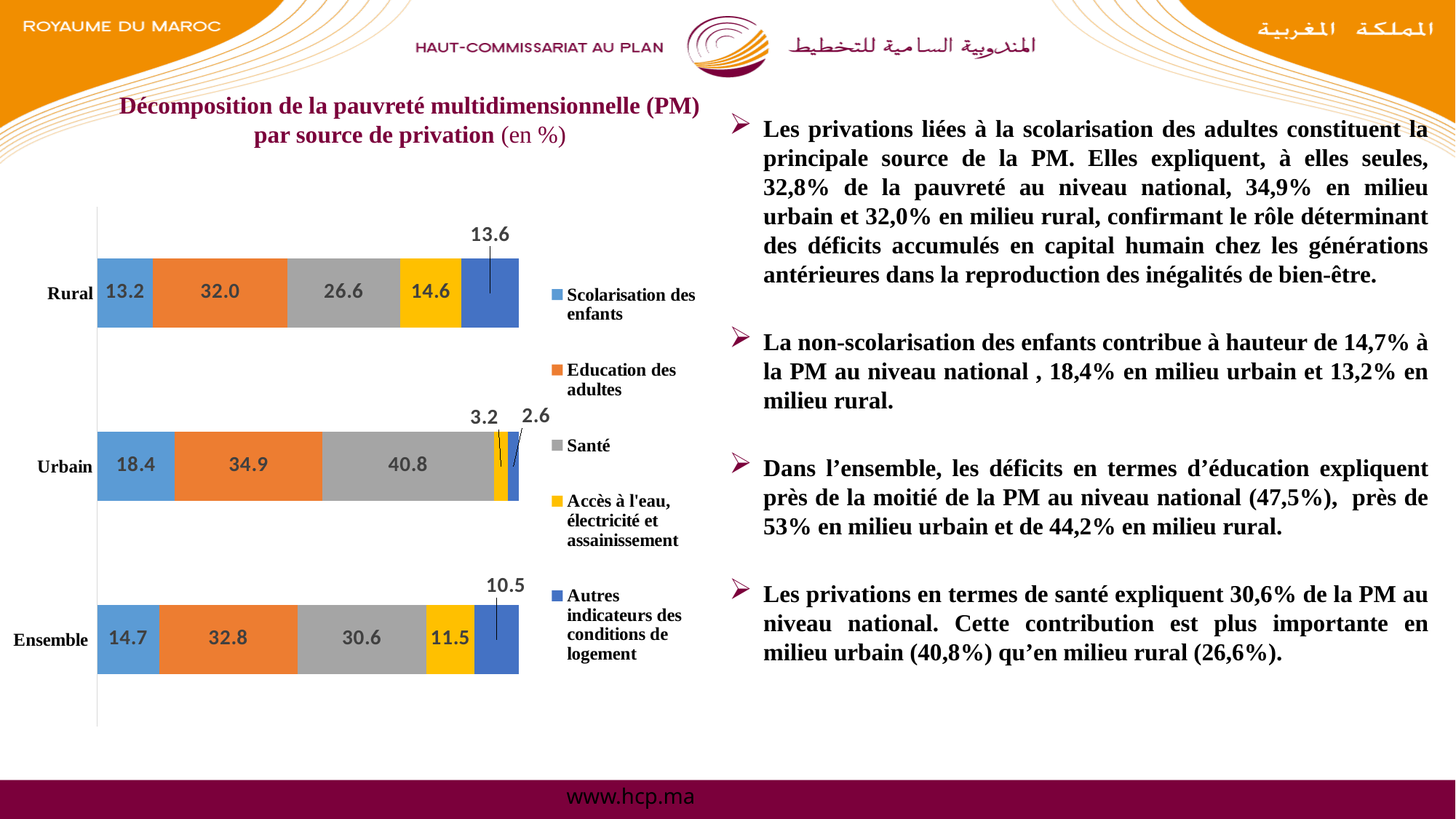
What type of chart is shown on the slide? Stacked bar chart How many series does the chart legend list? 5 What is the value of Accès à l'eau, électricité et assainissement for Urbain? 3.2 What is the value of Autres indicateurs des conditions de logement for Ensemble? 10.5 Which category has the highest value for Scolarisation des enfants? Urbain What is the difference between the Santé values for Urbain and Rural? 14.2 What is the value of Santé for Urbain? 40.8 How many categories (bars) are shown in the chart? 3 Which is larger: Education des adultes for Urbain or for Ensemble? Urbain What is the total of the stacked bar for Rural? 100.0 What is the value of Education des adultes for Rural? 32.0 Which category has the lowest value for Santé? Rural